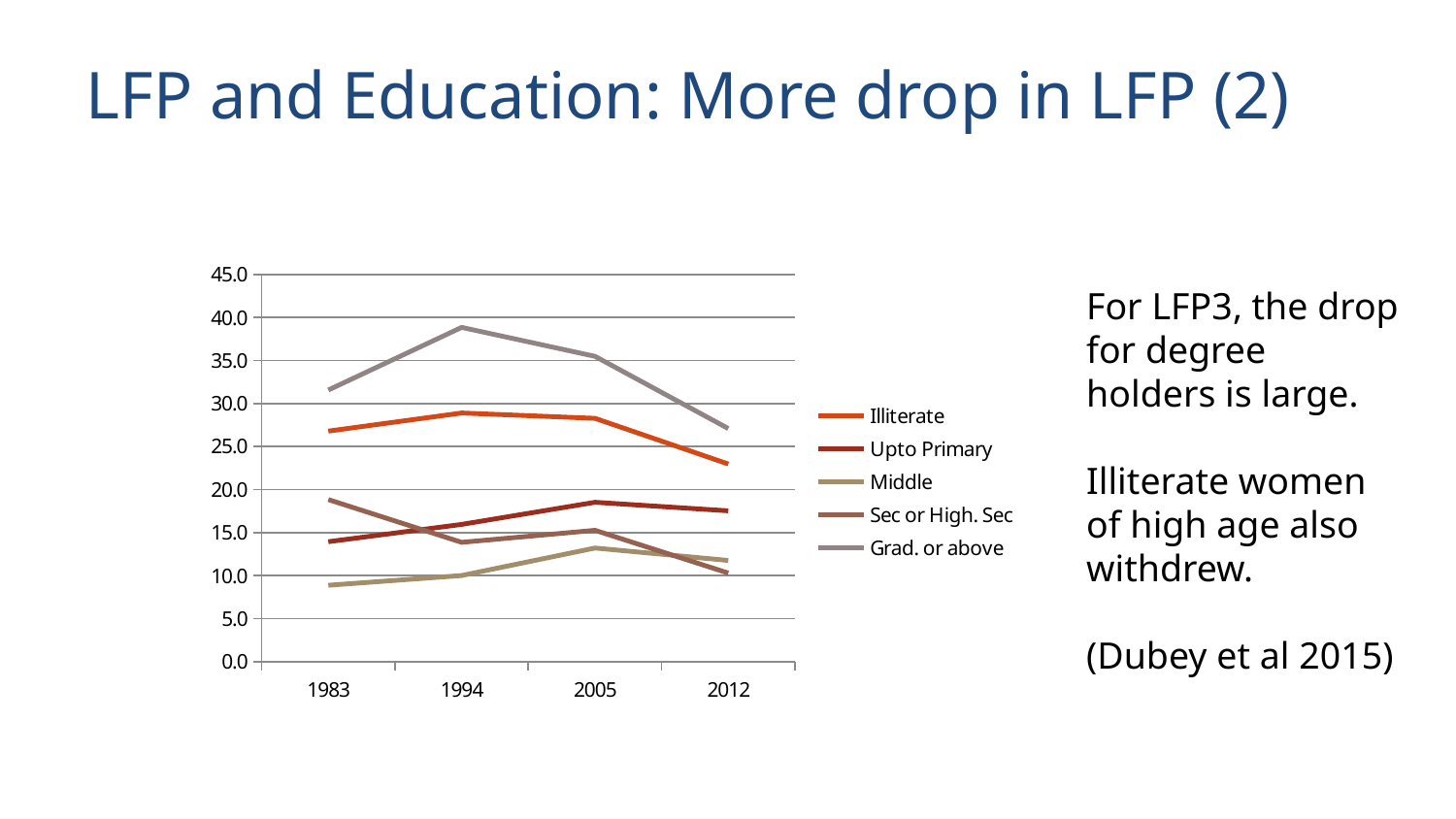
Which series is listed first in the legend? Illiterate Is the value for Middle in 1983 greater or less than 10.0? less Which series has the highest value in 1994? Grad. or above How many series does the legend list? 5 Is the value for Sec or High. Sec in 2012 greater or less than 15.0? less Is the value for Illiterate in 2012 greater or less than 25.0? less In 2012, which is larger: the value for Upto Primary or the value for Sec or High. Sec? Upto Primary How many years are shown on the x axis? 4 Which series has the lowest value in 1983? Middle What kind of chart is shown on the slide? Line chart Does the Grad. or above series rise or fall from 1994 to 2012? Falls